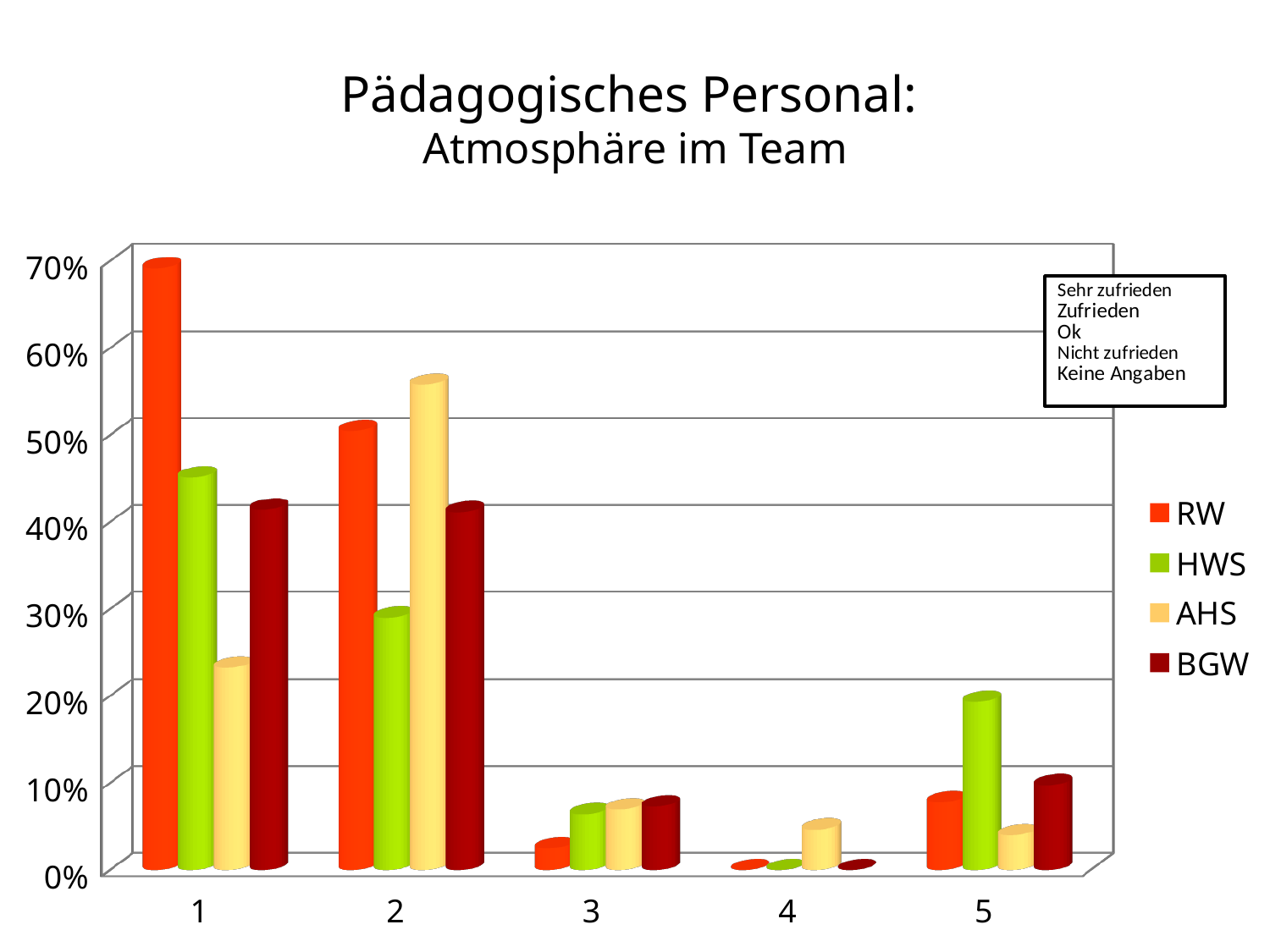
Which series has the highest value in category 5? HWS How many series does the legend list? 4 What kind of chart is shown on the slide? bar chart Is the value for HWS in category 2 greater or less than 40%? less Which series has the highest value in category 2? AHS How many categories are shown on the x axis? 5 Is the value for RW in category 1 greater or less than 60%? greater Is the value for AHS in category 1 greater or less than 30%? less What is the title of the chart? Pädagogisches Personal: Atmosphäre im Team Which series has the lowest value in category 1? AHS Which series has the highest value in category 1? RW In category 2, which is larger: the value for RW or the value for HWS? RW